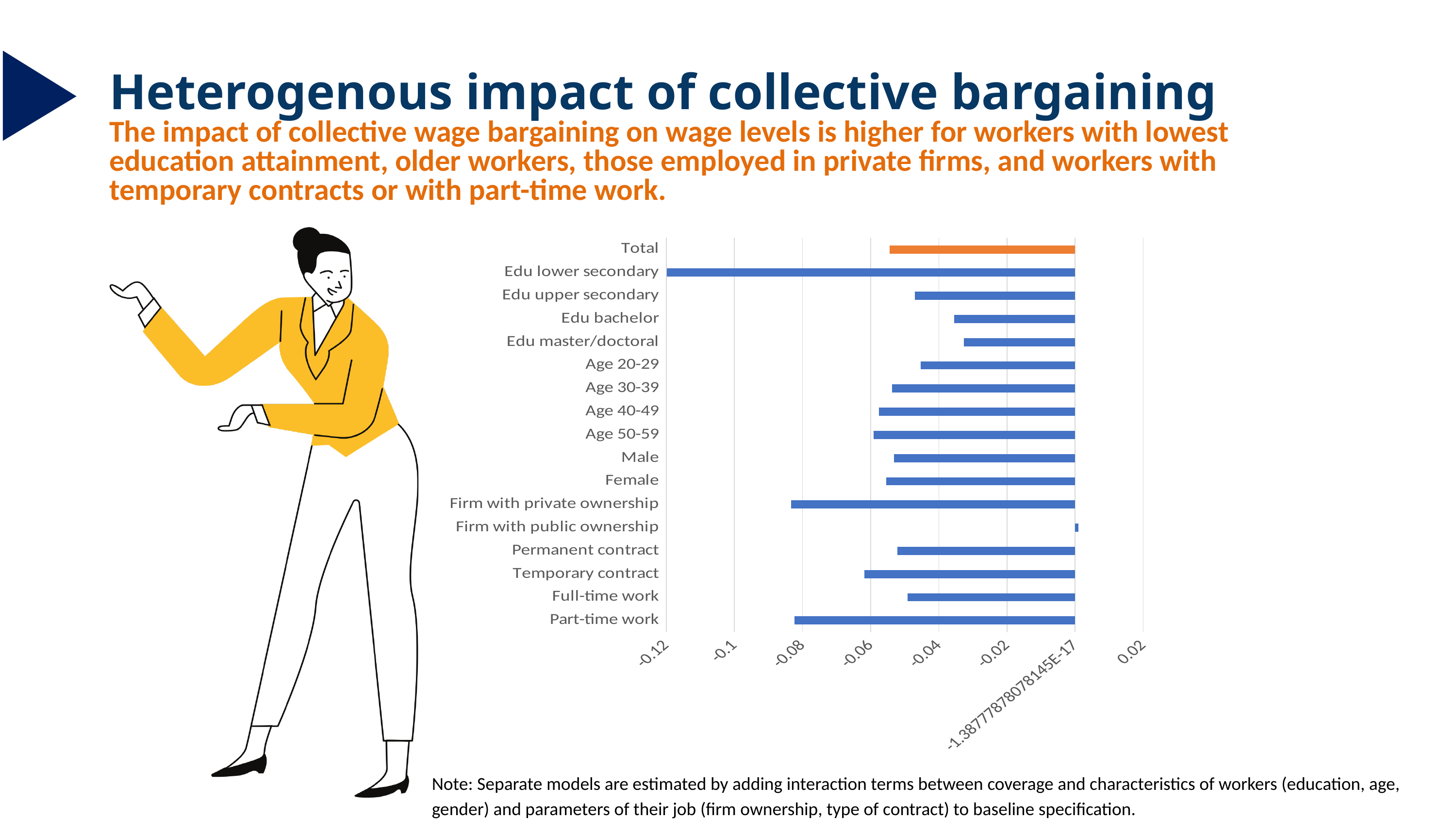
Which category's bar is coloured orange rather than blue? Total Which has the lower value, Firm with private ownership or Firm with public ownership? Firm with private ownership Is the value for Firm with private ownership greater or less than -0.06? less Which category has the lowest (most negative) value in the chart? Edu lower secondary What kind of chart is shown on the slide? bar chart Is the value for Edu lower secondary greater or less than -0.1? less How many categories are plotted in the chart? 17 Is the value for Age 20-29 greater or less than -0.06? greater Which category has the highest value in the chart? Firm with public ownership Which has the lower value, Edu lower secondary or Edu bachelor? Edu lower secondary